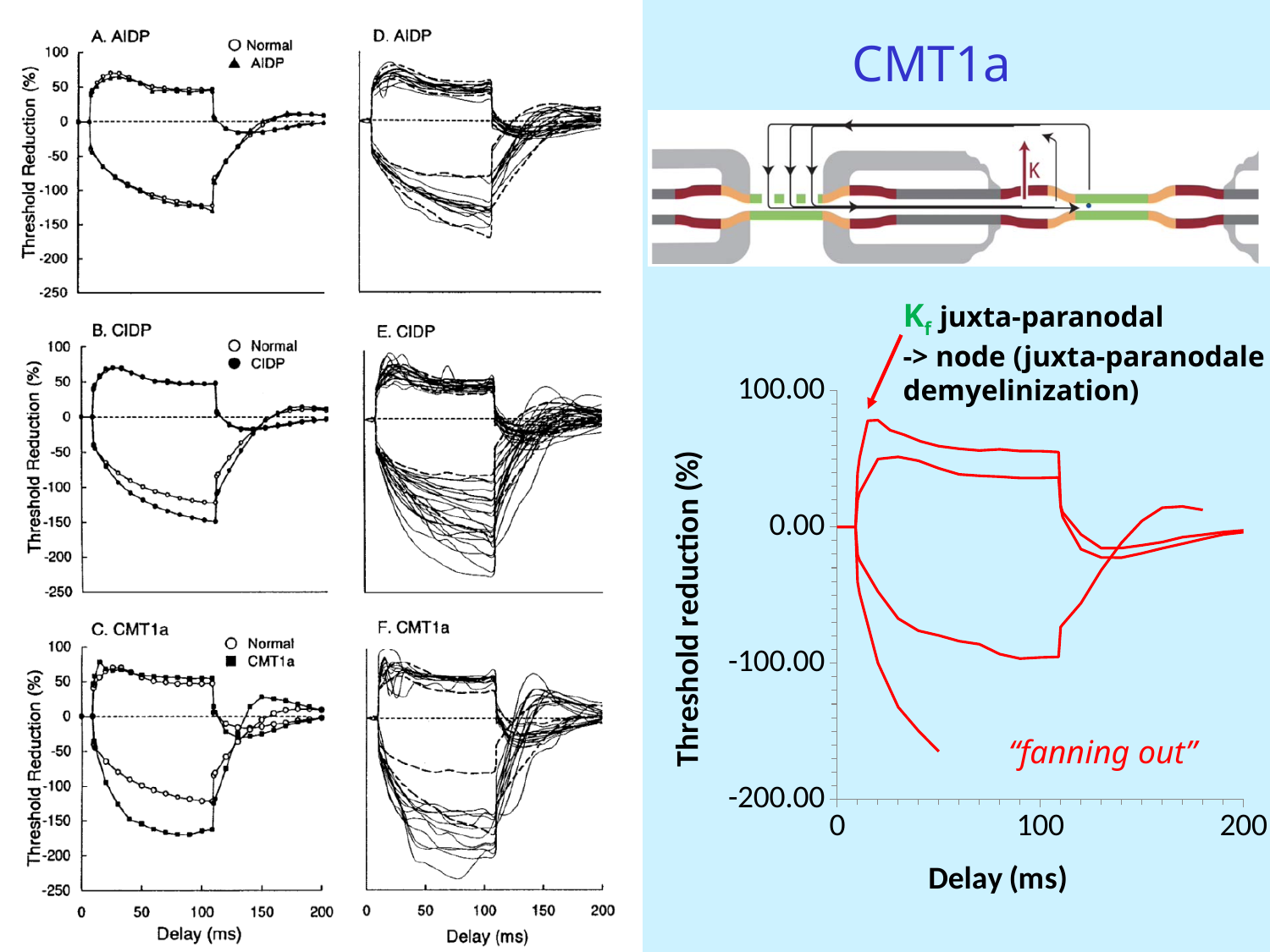
In the CMT1a chart on the right, is the highest point reached by the upper red curve greater or less than 100.00? less In panel A (AIDP) on the left, is the AIDP value at a delay of 100 ms greater or less than -100? less In panel B (CIDP) on the left, is the CIDP value at a delay of 100 ms greater or less than -100? less In the CMT1a chart on the right, how many tick labels are shown on the x axis? 3 In the CMT1a chart on the right, what is the label of the y axis? Threshold reduction (%) What kind of chart is the CMT1a chart on the right side of the slide? line chart In the CMT1a chart on the right, does the lowest red curve rise or fall as delay increases from 0 to about 50 ms? fall How many chart panels are shown on the left side of the slide? 6 How many series does the legend of panel A (AIDP) on the left list? 2 In the CMT1a chart on the right, what is the label of the x axis? Delay (ms)